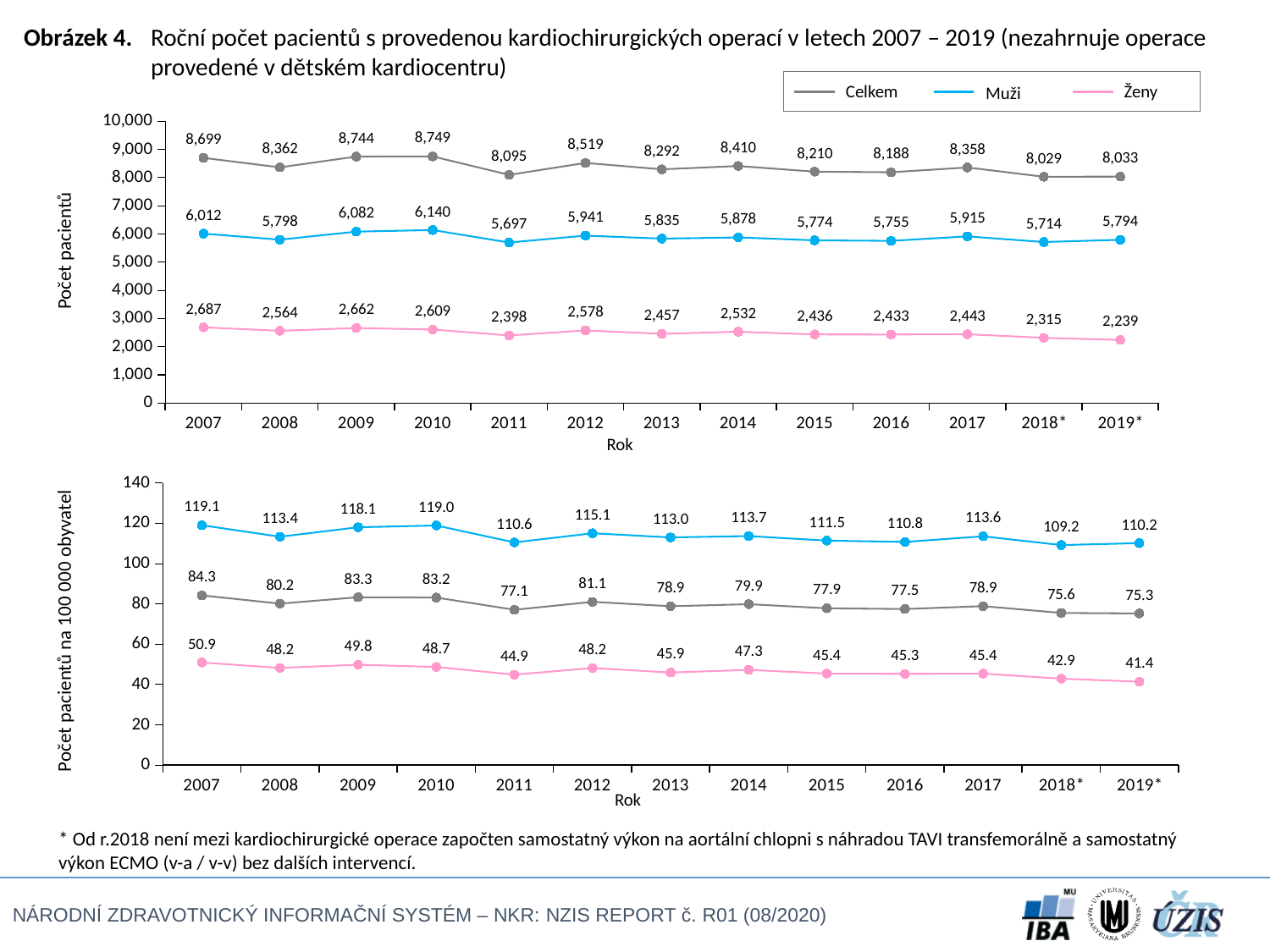
In the bottom chart (Počet pacientů na 100 000 obyvatel), in which year is the Celkem value highest? 2007 How many years are shown on the x axis of the top chart? 13 In the top chart (Počet pacientů), in which year is the Muži value lowest? 2011 In the top chart (Počet pacientů), what is the value for Celkem in 2010? 8,749 In the bottom chart (Počet pacientů na 100 000 obyvatel), which is larger: the Muži value in 2017 or the Muži value in 2018*? 2017 In the top chart (Počet pacientů), what is the value for Ženy in 2011? 2,398 How many series does the legend list? 3 In the bottom chart (Počet pacientů na 100 000 obyvatel), what is the difference between the Celkem values for 2007 and 2019*? 9.0 In the bottom chart (Počet pacientů na 100 000 obyvatel), in which year is the Ženy value lowest? 2019* In the top chart (Počet pacientů), what is the difference between the Celkem values for 2007 and 2019*? 666 In the bottom chart (Počet pacientů na 100 000 obyvatel), what is the value for Muži in 2012? 115.1 In the top chart (Počet pacientů), in which year is the Celkem value highest? 2010